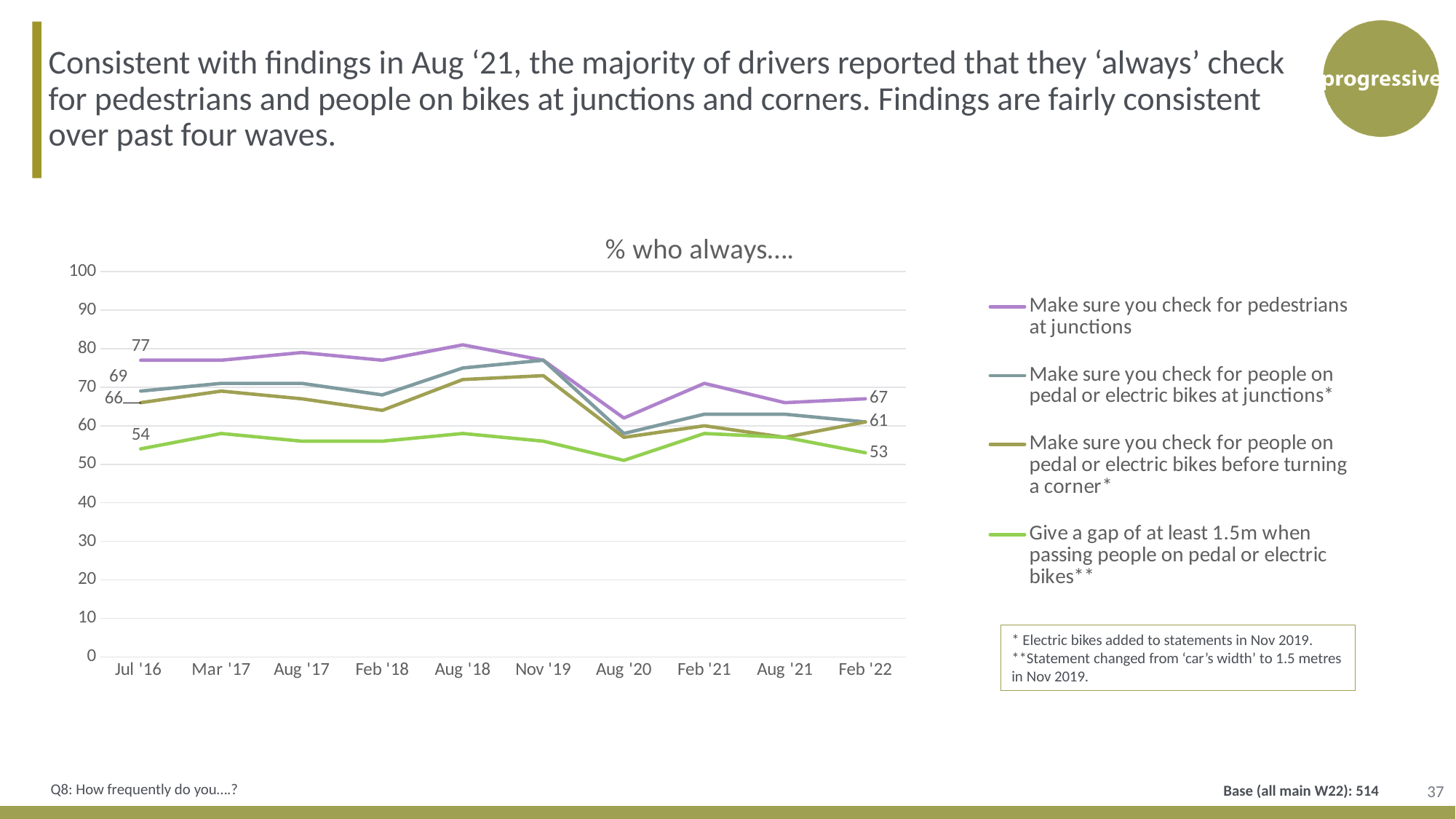
What is the title of the chart? % who always.... How many time points are shown on the x axis? 10 What is the value for 'Give a gap of at least 1.5m when passing people on pedal or electric bikes' in Feb '22? 53 Is the value for 'Give a gap of at least 1.5m when passing people on pedal or electric bikes' in Aug '20 greater or less than 60? less What is the value for 'Make sure you check for pedestrians at junctions' in Feb '22? 67 How many series does the legend list? 4 What is the value for 'Make sure you check for pedestrians at junctions' in Jul '16? 77 Which series has the lowest value in Feb '22? Give a gap of at least 1.5m when passing people on pedal or electric bikes What is the value for 'Make sure you check for people on pedal or electric bikes before turning a corner' in Jul '16? 66 What is the difference between 'Make sure you check for pedestrians at junctions' and 'Give a gap of at least 1.5m when passing people on pedal or electric bikes' in Jul '16? 23 Which series has the highest value in Jul '16? Make sure you check for pedestrians at junctions What type of chart is shown on the slide? line chart